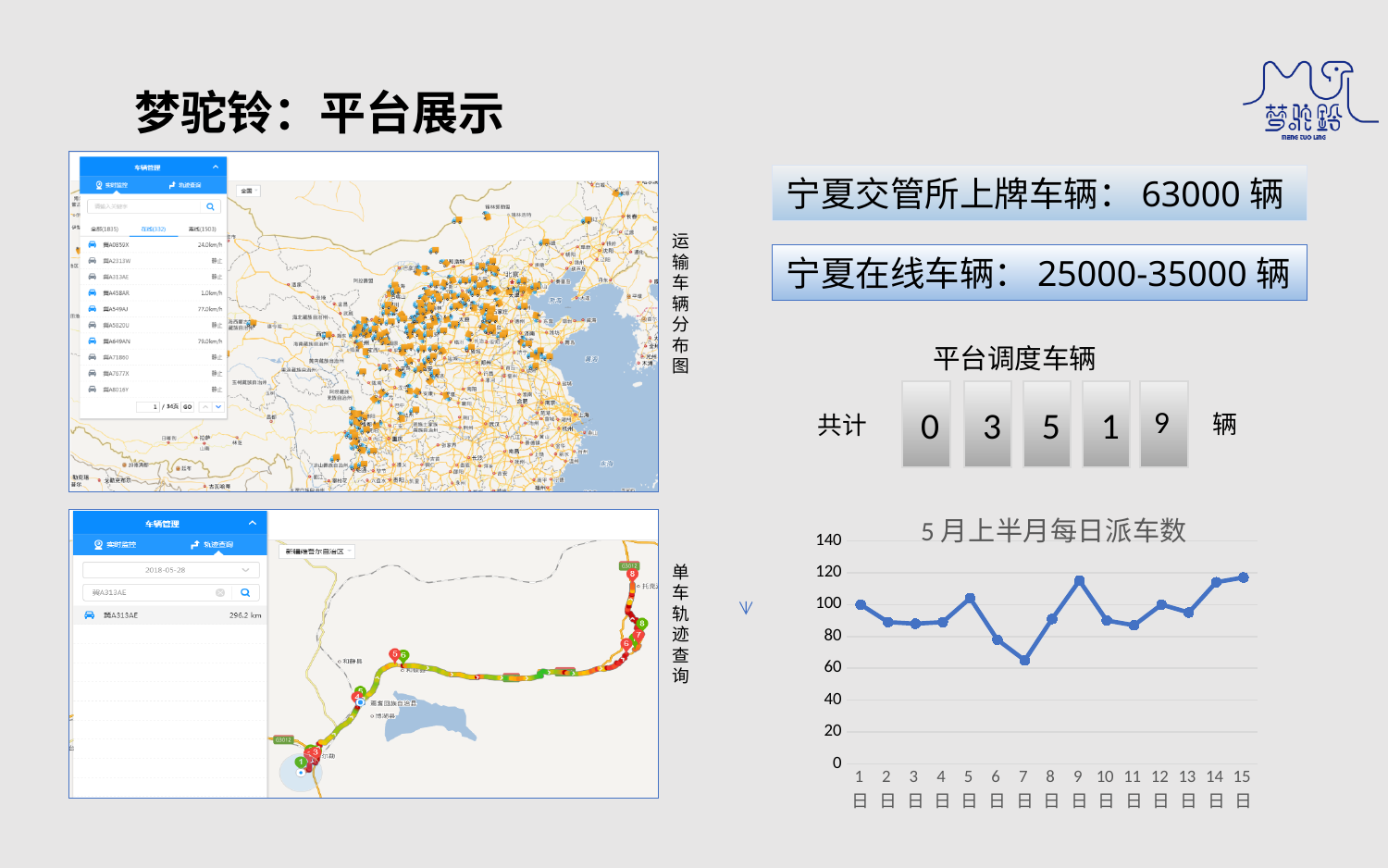
In the "5月上半月每日派车数" chart, is the value for 2日 greater or less than 100? less In the "5月上半月每日派车数" chart, do the values rise or fall from 5日 to 7日? fall In the "5月上半月每日派车数" chart, which day has the larger value, 9日 or 7日? 9日 What kind of chart is the "5月上半月每日派车数" chart? line chart In the "5月上半月每日派车数" chart, is the value for 6日 greater or less than 60? greater How many days are plotted on the x axis of the "5月上半月每日派车数" chart? 15 In the "5月上半月每日派车数" chart, which day has the lowest value? 7日 In the "5月上半月每日派车数" chart, is the value for 15日 greater or less than 100? greater What is the title of the line chart on the slide? 5月上半月每日派车数 In the "5月上半月每日派车数" chart, which day has the larger value, 5日 or 6日? 5日